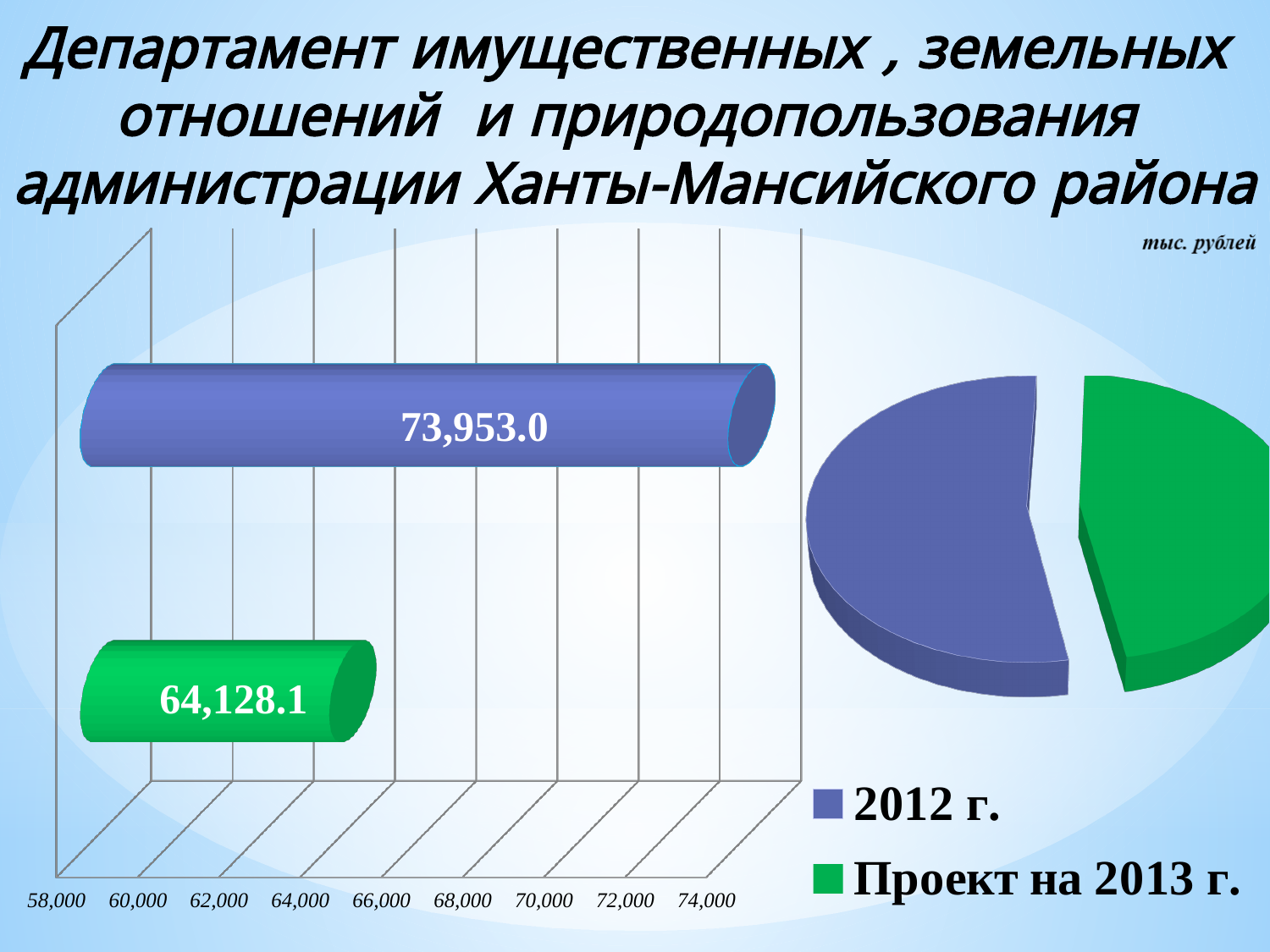
How many bars are plotted on the bar chart? 2 On the pie chart on the right, which slice is larger: 2012 г. or Проект на 2013 г.? 2012 г. On the bar chart, which series has the lowest value? Проект на 2013 г. How many series does the legend list? 2 On the bar chart, is the value for Проект на 2013 г. greater or less than 66,000? less On the bar chart, is the value for 2012 г. greater or less than 72,000? greater On the bar chart, which series has the highest value? 2012 г. What kind of chart is the chart on the left side of the slide? bar chart On the bar chart, what is the value for Проект на 2013 г.? 64,128.1 On the bar chart, what is the difference between the value for 2012 г. and the value for Проект на 2013 г.? 9,824.9 On the bar chart, which is larger: the value for 2012 г. or the value for Проект на 2013 г.? 2012 г. On the bar chart, what is the value for 2012 г.? 73,953.0